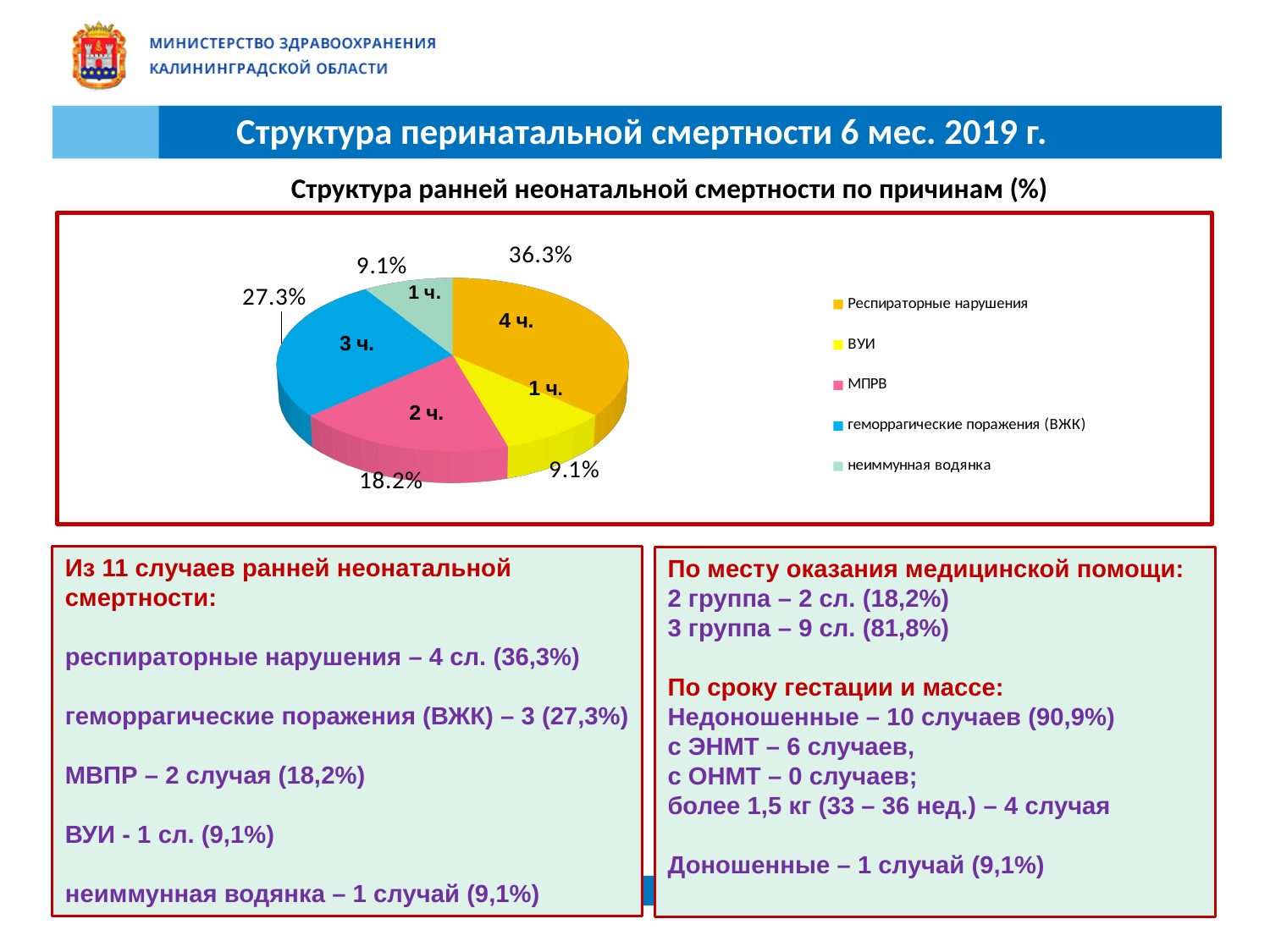
Which slice is larger: геморрагические поражения (ВЖК) or МПРВ? геморрагические поражения (ВЖК) How many cases (ч.) are shown on the slice for геморрагические поражения (ВЖК)? 3 ч. What percentage share does the slice for геморрагические поражения (ВЖК) have? 27.3% Which category has the largest slice of the pie? Респираторные нарушения What percentage share does the slice for Респираторные нарушения have? 36.3% What is the title of the chart? Структура ранней неонатальной смертности по причинам (%) What colour is the slice for неиммунная водянка? light green What percentage share does the slice for МПРВ have? 18.2% How many categories does the legend list? 5 What is the difference in percentage points between the Респираторные нарушения slice and the МПРВ slice? 18.1 What percentage share does the slice for ВУИ have? 9.1% What kind of chart is shown on the slide? pie chart